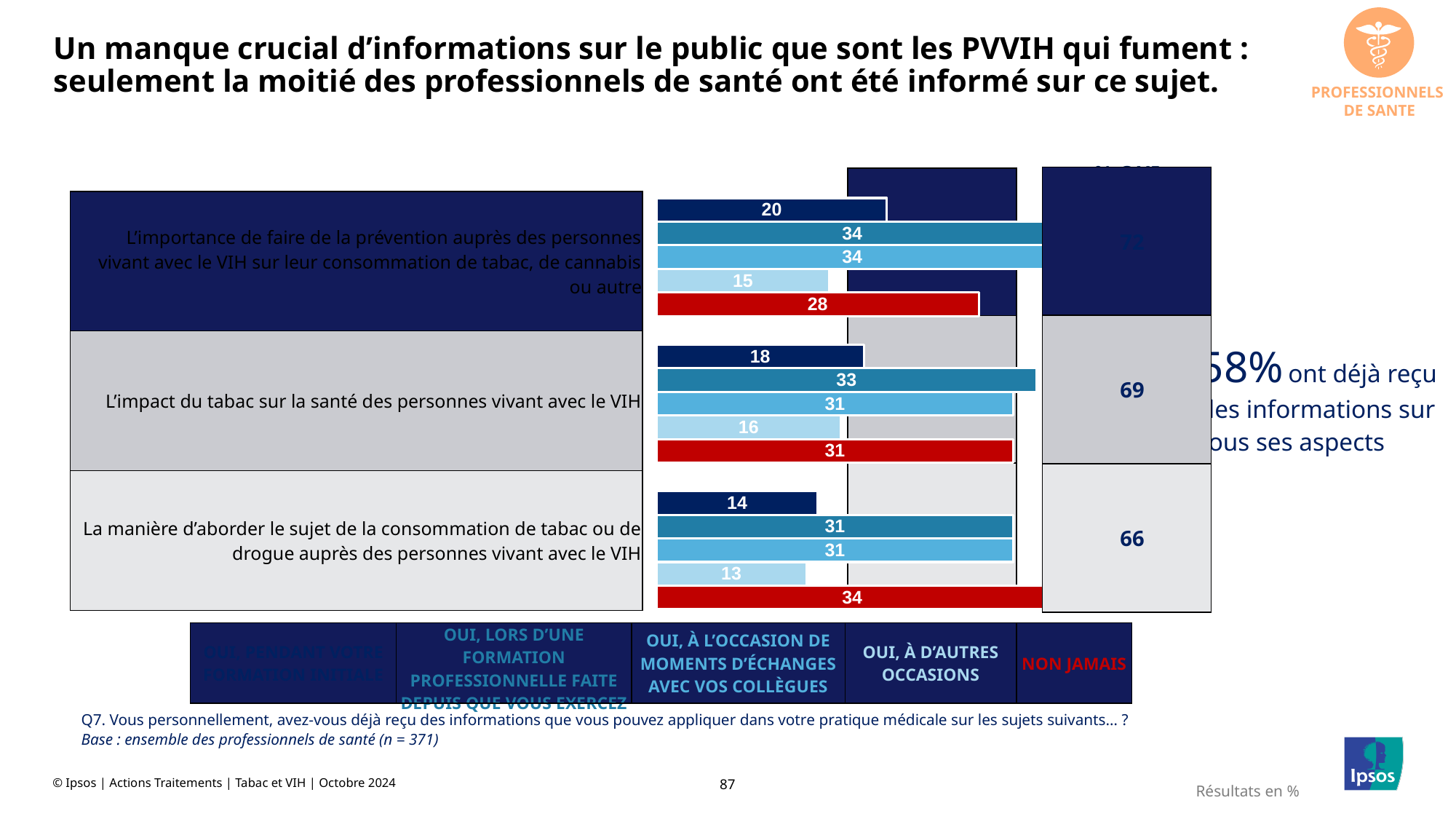
For "OUI, À L'OCCASION DE MOMENTS D'ÉCHANGES AVEC VOS COLLÈGUES", which is larger: "L'importance de faire de la prévention..." or "L'impact du tabac sur la santé..."? L'importance de faire de la prévention auprès des personnes vivant avec le VIH sur leur consommation de tabac, de cannabis ou autre Which category has the highest value for "NON JAMAIS"? La manière d'aborder le sujet de la consommation de tabac ou de drogue auprès des personnes vivant avec le VIH How many categories (subjects) are shown in the chart? 3 What is the value of "OUI, À D'AUTRES OCCASIONS" for "La manière d'aborder le sujet de la consommation de tabac ou de drogue auprès des personnes vivant avec le VIH"? 13 How many series does the legend list? 5 What is the value of "OUI, LORS D'UNE FORMATION PROFESSIONNELLE FAITE DEPUIS QUE VOUS EXERCEZ" for "L'importance de faire de la prévention auprès des personnes vivant avec le VIH sur leur consommation de tabac, de cannabis ou autre"? 34 Which category has the lowest value for "OUI, À D'AUTRES OCCASIONS"? La manière d'aborder le sujet de la consommation de tabac ou de drogue auprès des personnes vivant avec le VIH What is the difference in "NON JAMAIS" between "La manière d'aborder le sujet..." and "L'importance de faire de la prévention..."? 6 What is the total "OUI" value shown for "L'impact du tabac sur la santé des personnes vivant avec le VIH"? 69 What is the value of "NON JAMAIS" for "L'impact du tabac sur la santé des personnes vivant avec le VIH"? 31 What kind of chart is shown on the slide? Bar chart What colour are the "NON JAMAIS" bars? Red